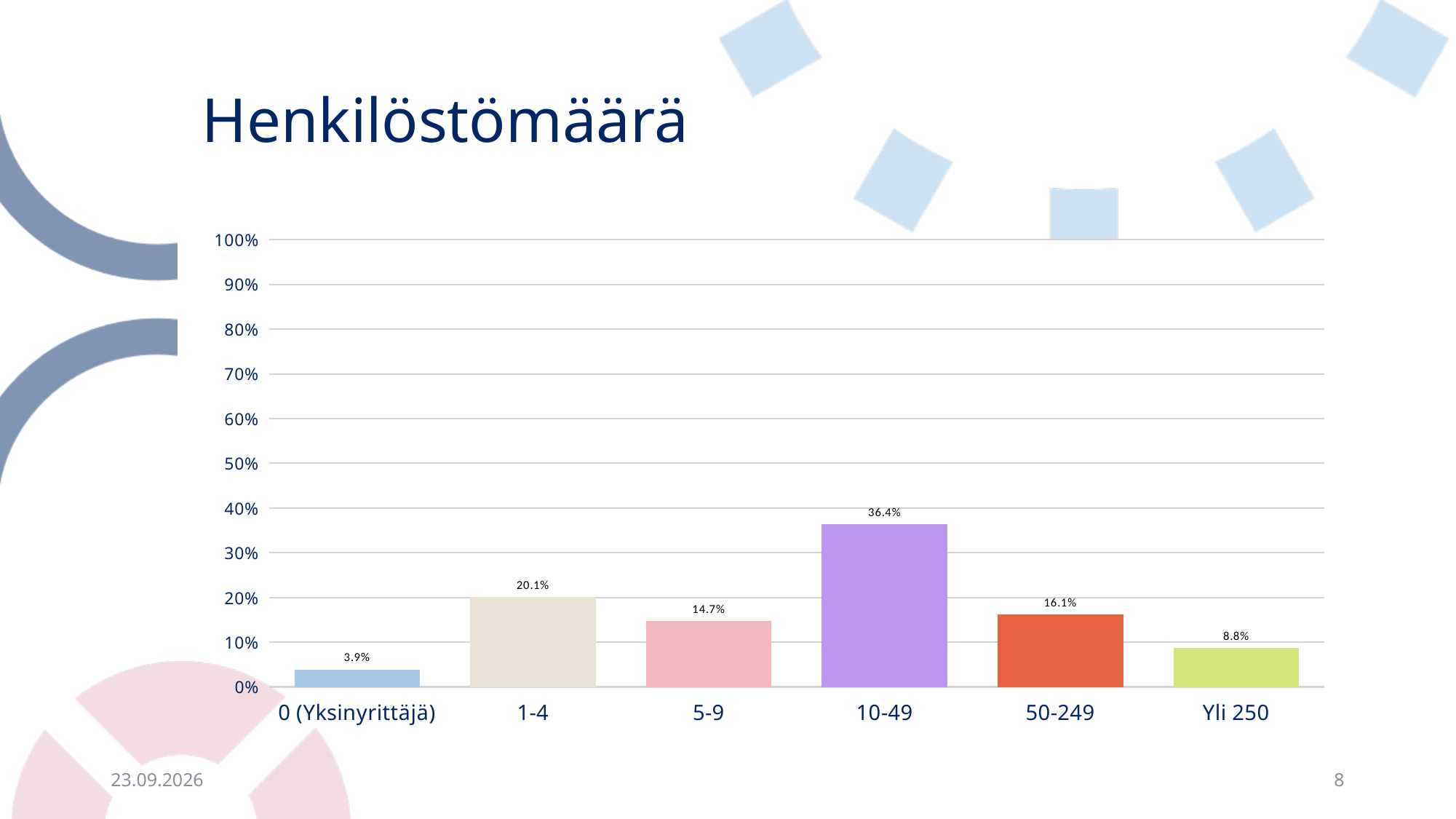
What is the difference between the values for 10-49 and 1-4? 16.3% Which category has the lowest value? 0 (Yksinyrittäjä) How many categories are shown on the x axis? 6 What is the value for the 0 (Yksinyrittäjä) category? 3.9% What is the difference between the values for 50-249 and 5-9? 1.4% Which category has the highest value? 10-49 What is the title of the slide? Henkilöstömäärä What is the value for the Yli 250 category? 8.8% What kind of chart is shown on the slide? bar chart What is the value for the 10-49 category? 36.4% Is the value for 10-49 greater or less than 30%? greater Which is larger, the value for 1-4 or the value for 50-249? 1-4